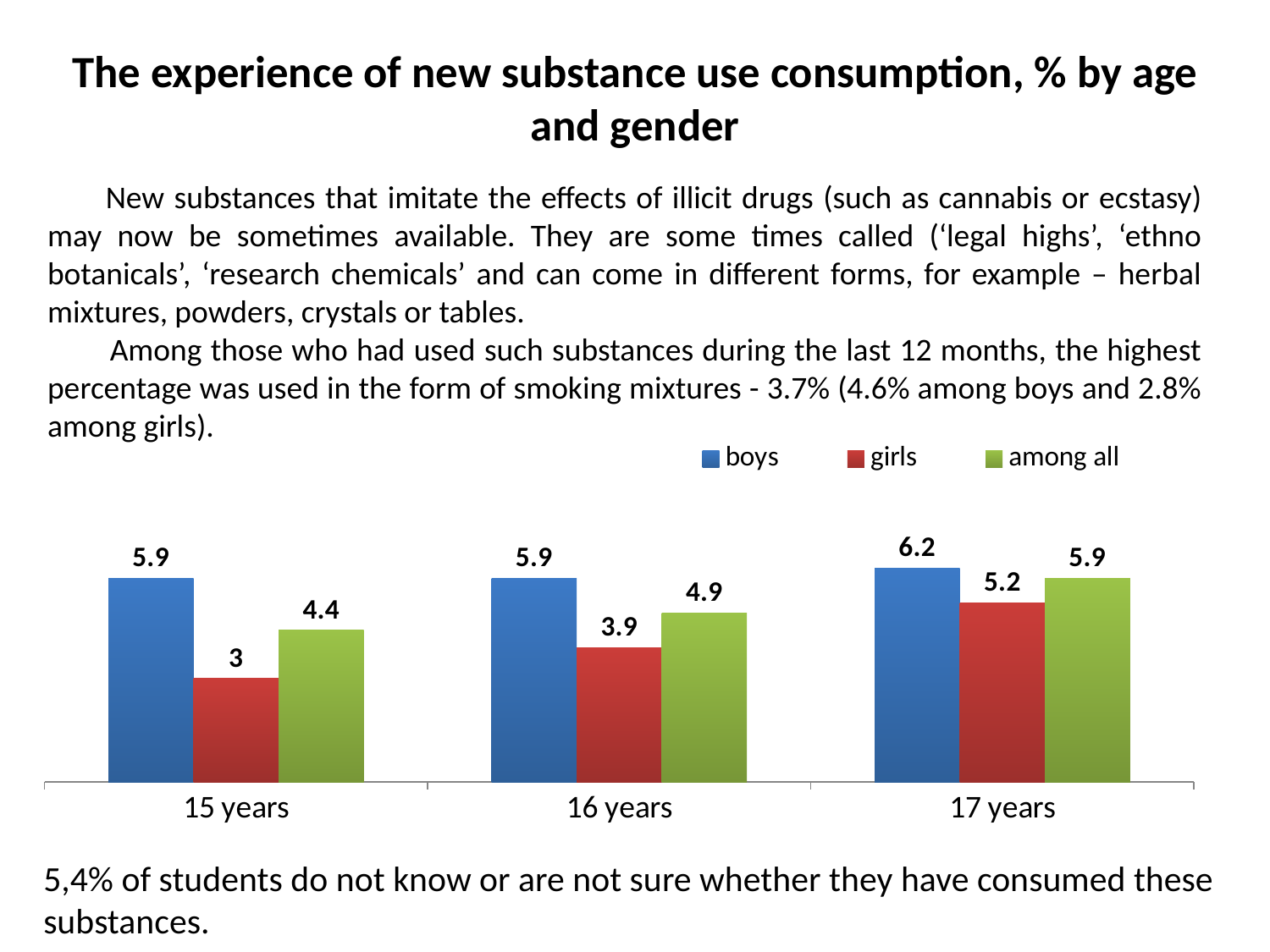
What is the value for girls at 15 years? 3 What kind of chart is shown on the slide? bar chart What is the value for boys at 15 years? 5.9 Which is larger at 16 years: the value for boys or the value for 'among all'? boys How many age groups are shown on the x axis? 3 What is the difference between the boys and girls values at 17 years? 1 Which age group has the lowest value for girls? 15 years Which age group has the highest value for boys? 17 years What is the value for girls at 16 years? 3.9 What is the value for 'among all' at 17 years? 5.9 How many series does the legend list? 3 What is the difference between the 'among all' values at 16 years and 15 years? 0.5